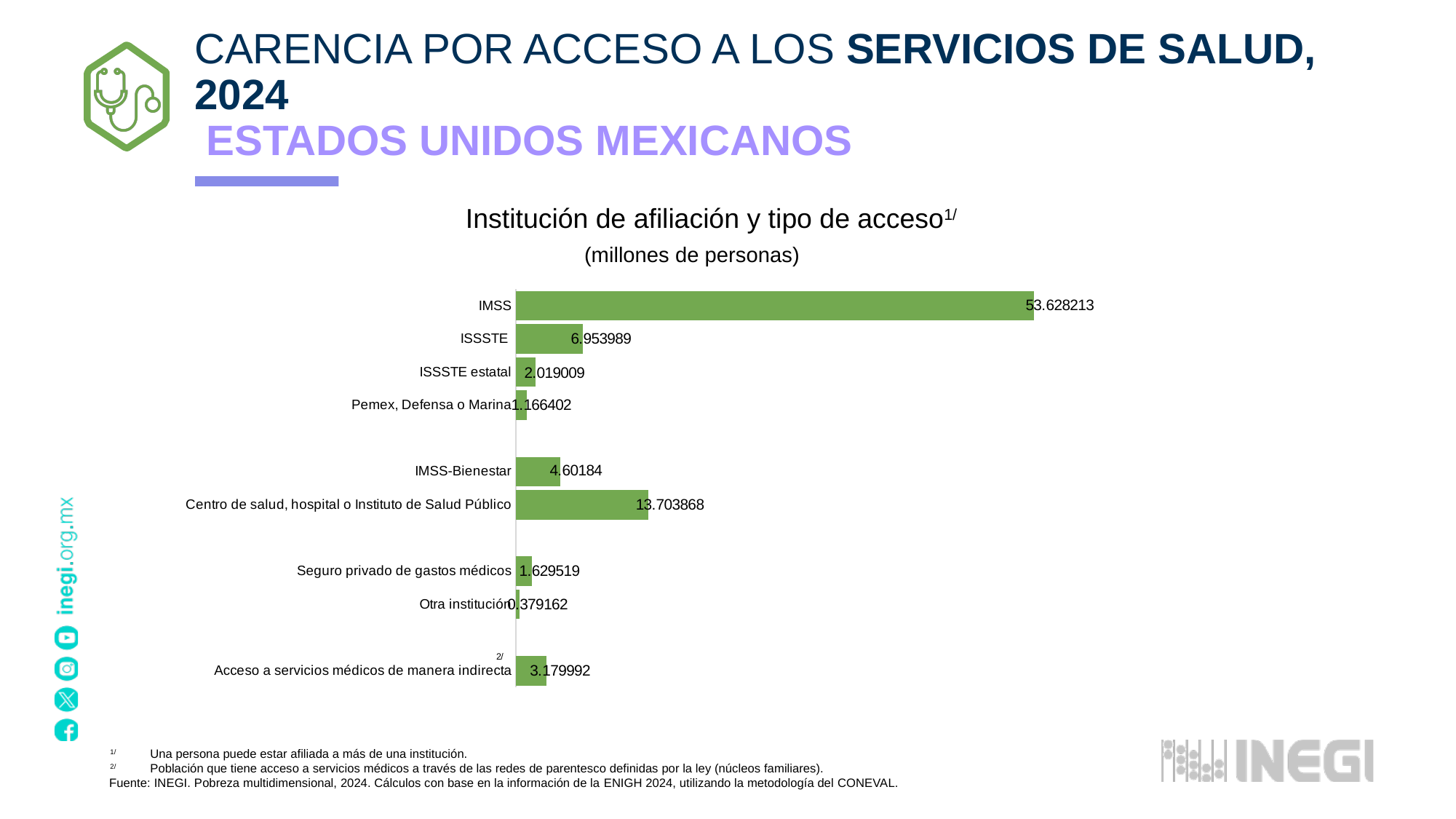
How many categories are shown in the chart? 9 What is the value for ISSSTE? 6.953989 What is the value for Otra institución? 0.379162 Which is larger, the value for Seguro privado de gastos médicos or the value for Acceso a servicios médicos de manera indirecta? Acceso a servicios médicos de manera indirecta What is the value for IMSS-Bienestar? 4.60184 Which category has the lowest value? Otra institución What kind of chart is shown on the slide? Bar chart What is the difference between the values for ISSSTE and ISSSTE estatal? 4.93498 What is the value for Centro de salud, hospital o Instituto de Salud Público? 13.703868 Which category has the highest value? IMSS What is the difference between the values for IMSS and Centro de salud, hospital o Instituto de Salud Público? 39.924345 What is the value for IMSS? 53.628213